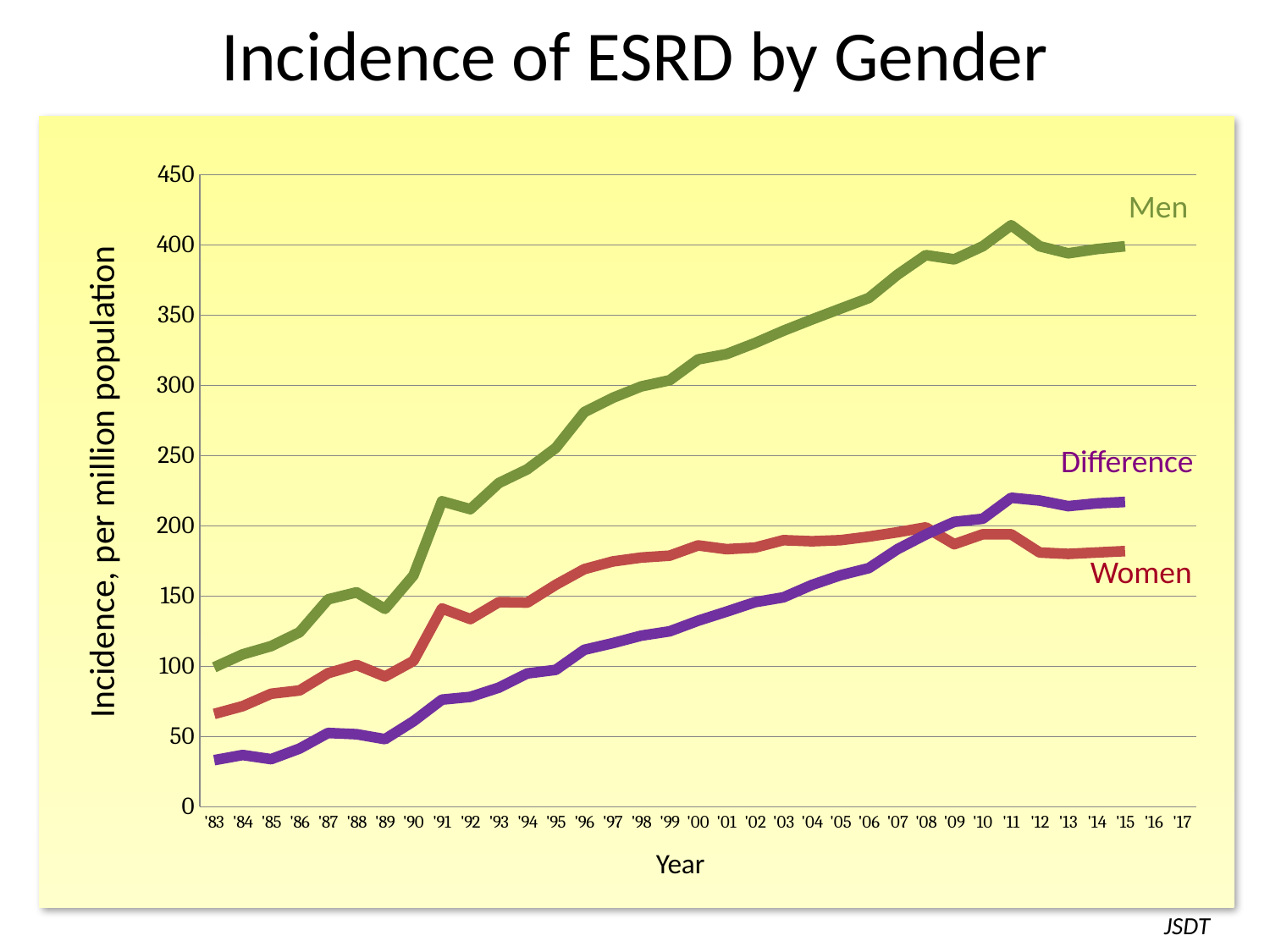
What is the title of the chart? Incidence of ESRD by Gender Is the value for Women in '15 greater or less than 200? less Does the Men series generally rise or fall from '83 to '11? rise Which series has the lowest value in '83? Difference Which series has the highest value in '15? Men What is the label of the y axis? Incidence, per million population Is the value for Difference in '83 greater or less than 50? less In '05, which is larger, the value for Women or the value for Difference? Women What kind of chart is shown on the slide? line chart Is the value for Men in '96 greater or less than 250? greater How many series are plotted on the chart? 3